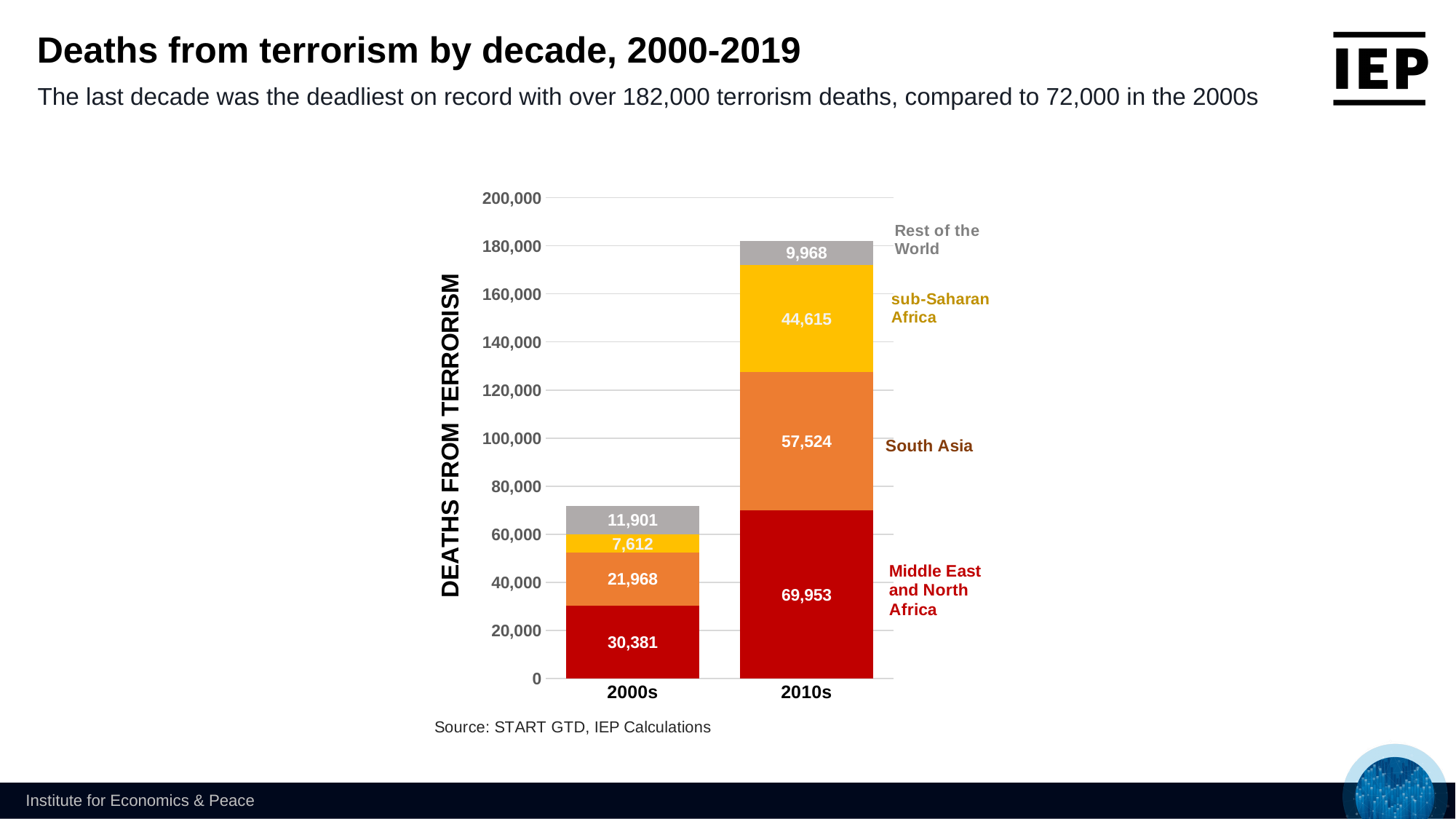
What is the difference between the Middle East and North Africa values for the 2010s and the 2000s? 39,572 What is the total of the stacked bar for the 2010s? 182,060 What is the value for South Asia in the 2000s? 21,968 What is the value for sub-Saharan Africa in the 2010s? 44,615 What is the value for Middle East and North Africa in the 2010s? 69,953 What is the value for Rest of the World in the 2000s? 11,901 Which region has the smallest segment in the 2000s bar? sub-Saharan Africa Which region has the largest segment in the 2010s bar? Middle East and North Africa Which is larger: the Rest of the World value in the 2000s or in the 2010s? 2000s What kind of chart is shown on the slide? Stacked bar chart What is the difference between the sub-Saharan Africa values for the 2010s and the 2000s? 37,003 How many regions are stacked in each bar? 4